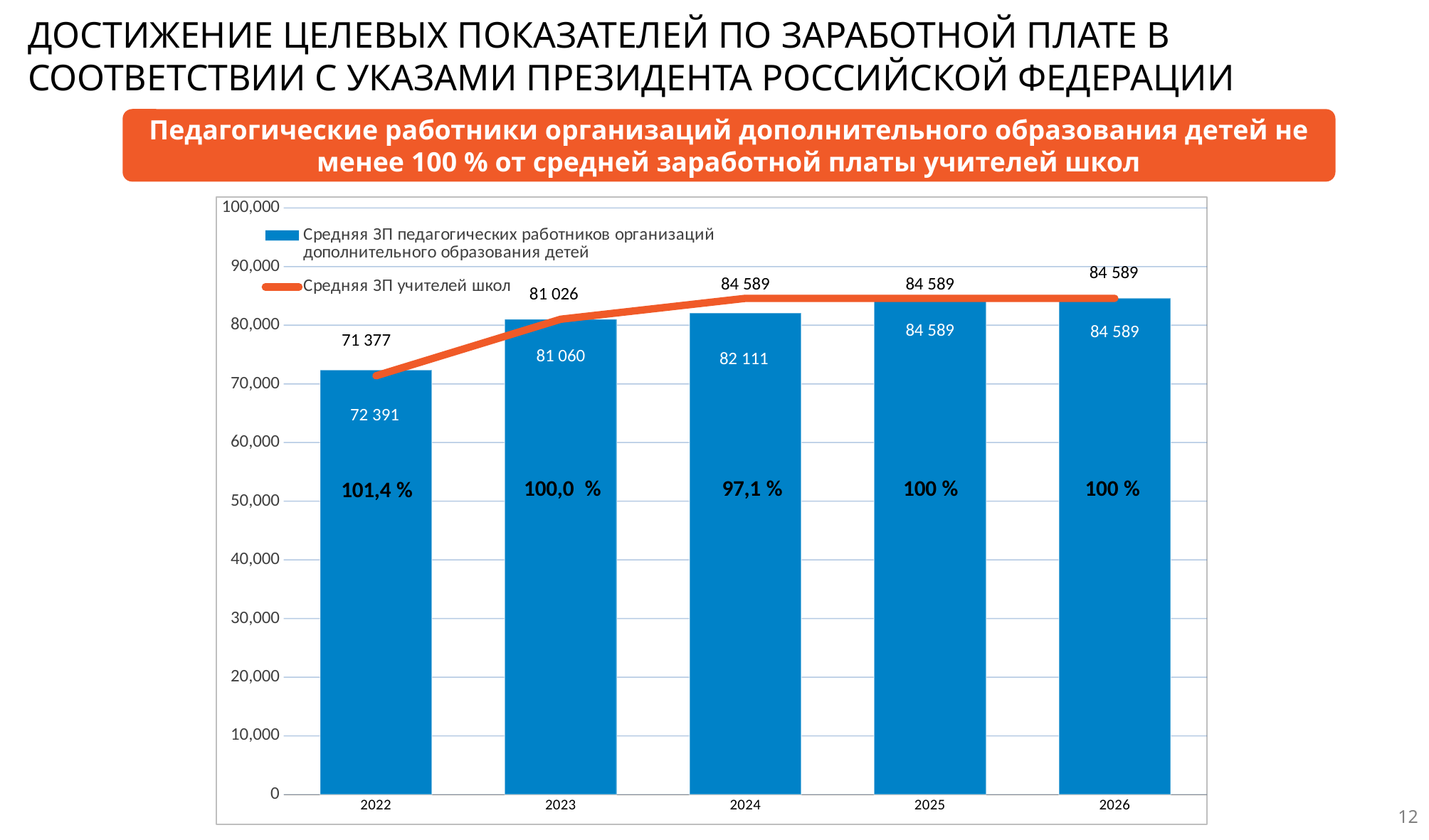
What is the difference between the blue bar values for 2023 and 2022? 8 669 How many years are shown on the x axis? 5 What is the average salary of pedagogical workers of supplementary education organizations (blue bar) in 2022? 72 391 What is the value of the blue bar for 2024? 82 111 How many series does the legend list? 2 What is the difference between the blue bar value and the orange line value in 2022? 1 014 Which year has the lowest value for the blue bar series? 2022 What percentage is shown inside the bar for 2024? 97,1 % What kind of chart is shown on the slide? a combined bar and line chart Do the blue bar values rise or fall from 2022 to 2025? rise What is the average salary of school teachers (orange line) in 2023? 81 026 In 2024, which is larger: the blue bar value or the orange line value? the orange line value (84 589)